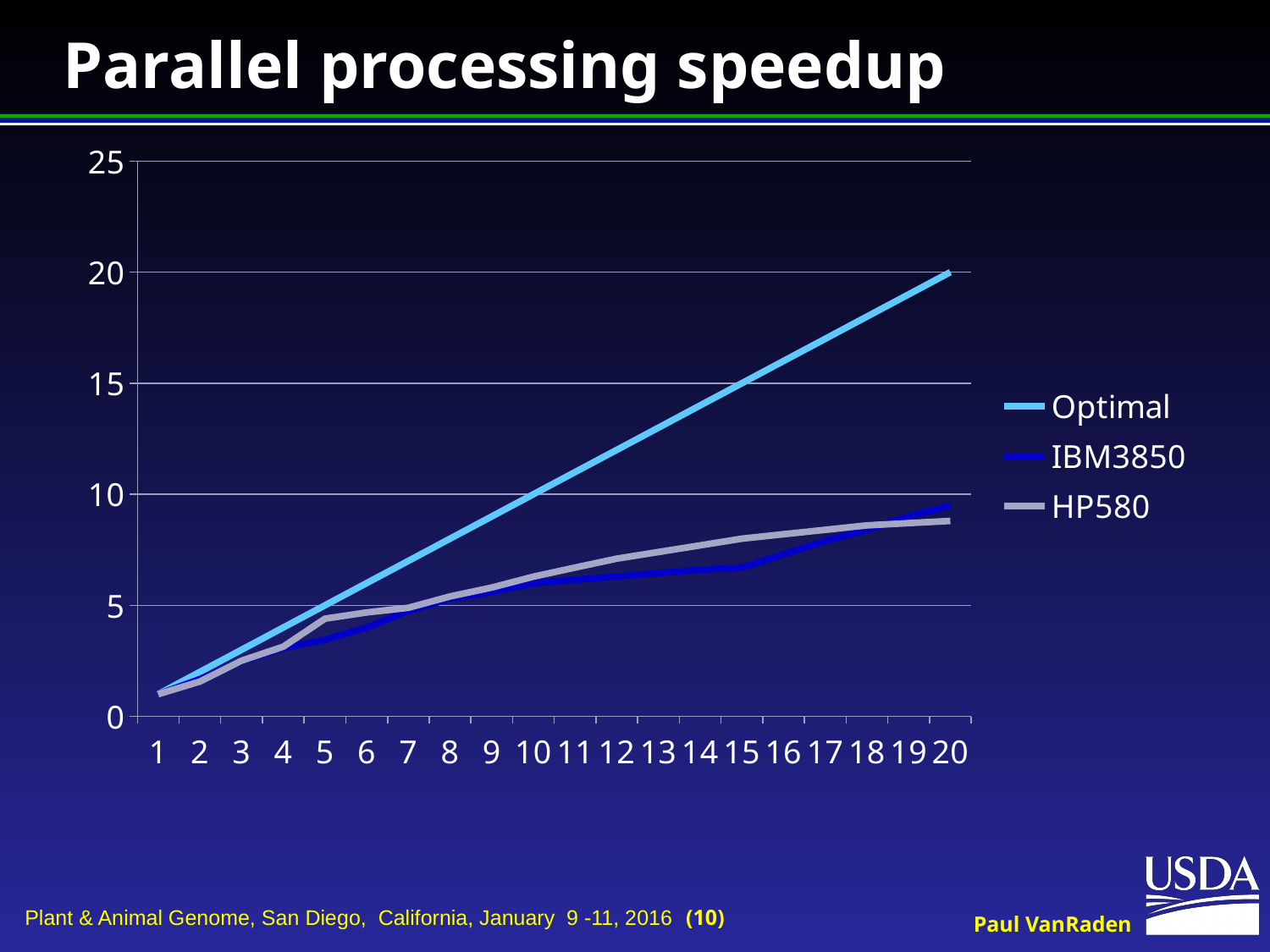
Does the Optimal series rise or fall as x increases from 1 to 20? rise What kind of chart is shown on the slide? line chart Is the value for IBM3850 at x = 20 greater or less than 10? less What is the value of the Optimal series at x = 20? 20 What is the title of the chart? Parallel processing speedup Is the value for HP580 at x = 20 greater or less than 10? less Is the value for IBM3850 at x = 10 greater or less than 5? greater What is the value of the Optimal series at x = 10? 10 How many points are plotted along the x axis for each series? 20 How many series does the legend list? 3 At x = 20, which series has the higher value, Optimal or IBM3850? Optimal